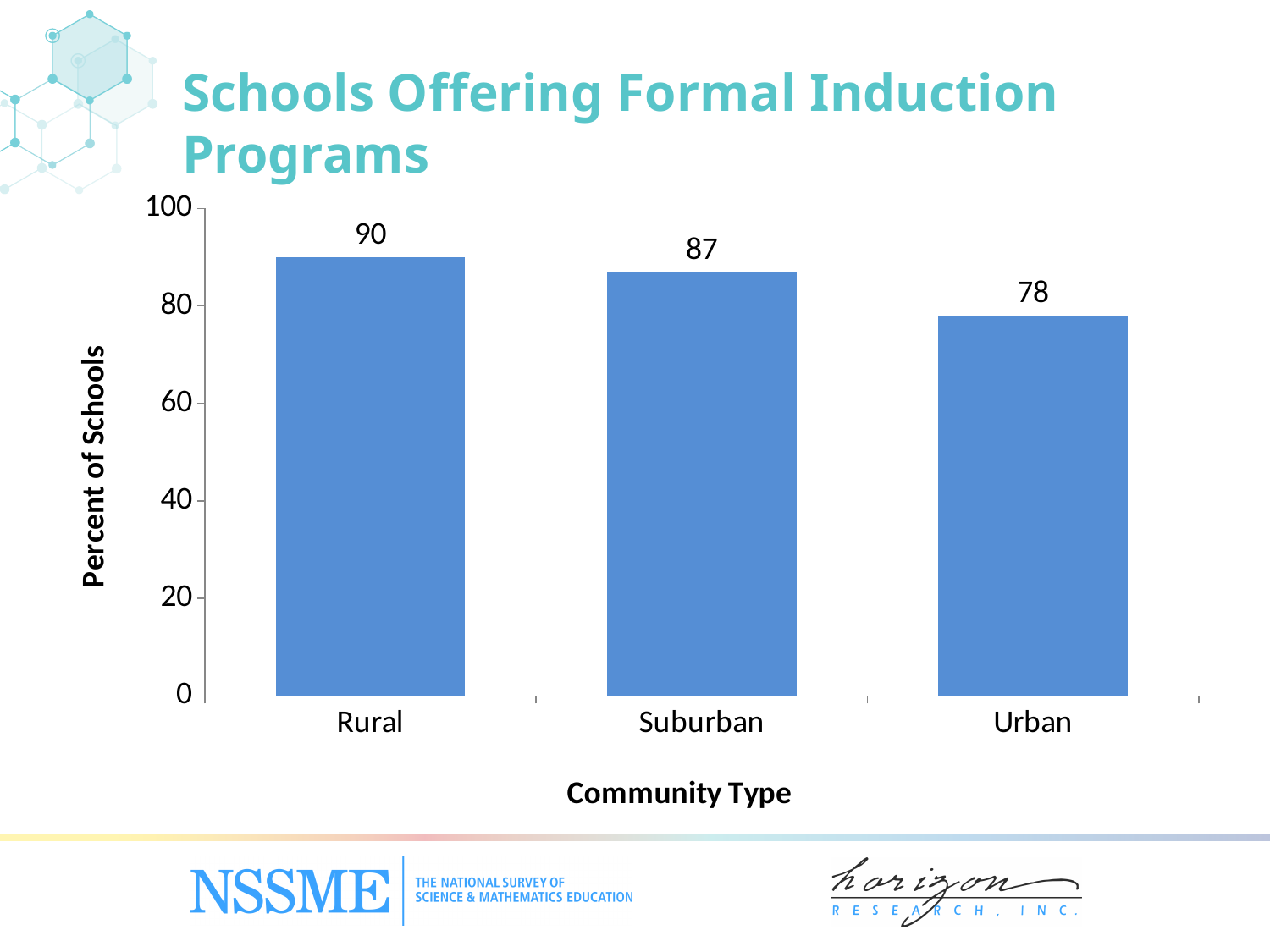
Which community type has the highest percent of schools offering formal induction programs? Rural Is the value for Urban greater or less than 80? less Which community type has the lowest percent of schools offering formal induction programs? Urban Which is larger, the value for Rural or the value for Suburban? Rural What percent of rural schools offer formal induction programs? 90 What is the difference between the values for Suburban and Urban schools? 9 What is the value for Urban schools? 78 What is the label of the y axis? Percent of Schools What is the value for Suburban schools? 87 How many community types are shown on the chart? 3 What is the difference between the values for Rural and Urban schools? 12 What kind of chart is shown on the slide? Bar chart